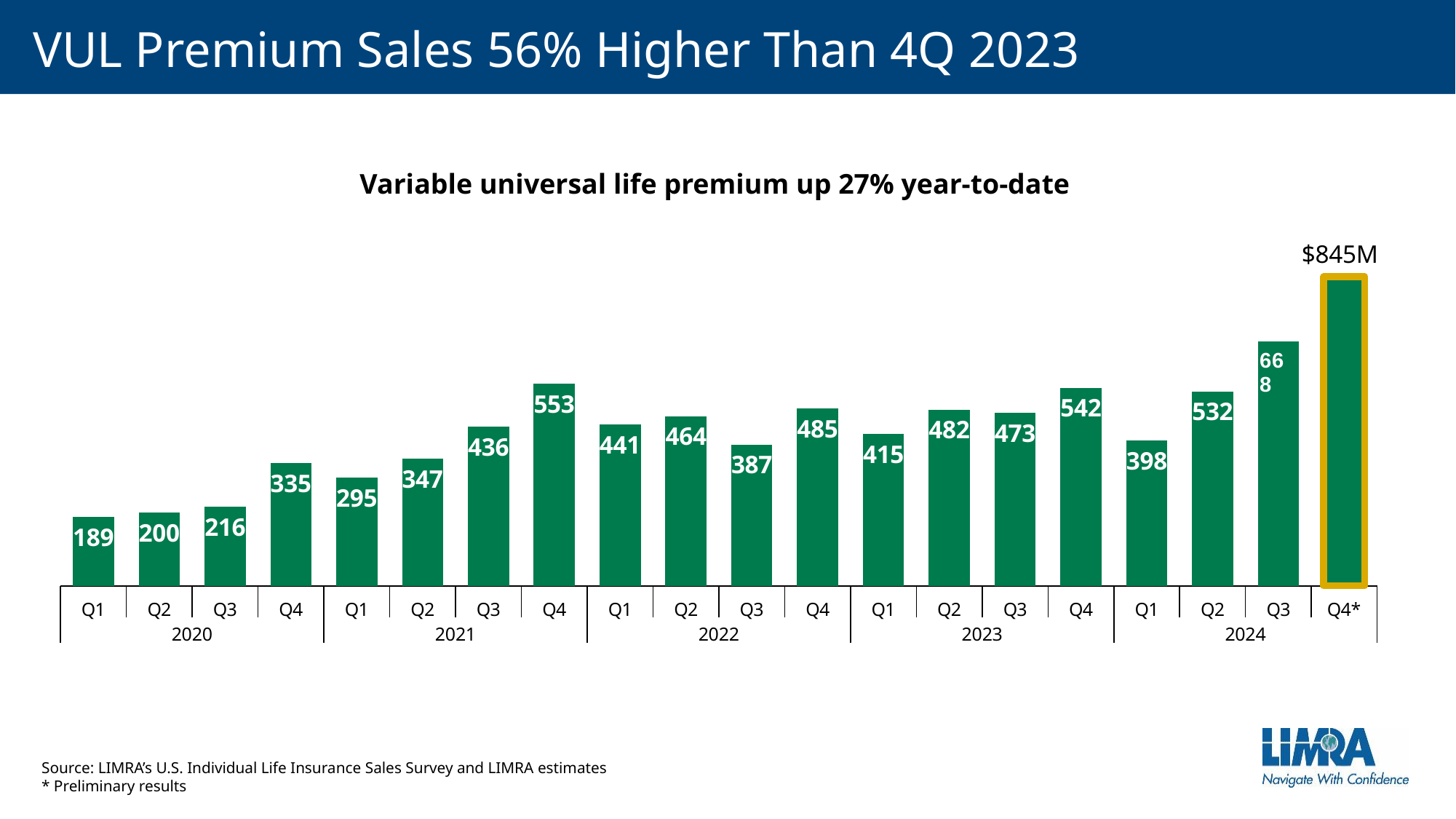
How many quarterly bars are plotted in the chart? 20 Which quarter has the highest value? Q4* 2024 What value is labelled above the Q4* 2024 bar? $845M What kind of chart is shown on the slide? Bar chart What is the difference between Q3 2024 and Q2 2024? 136 What is the value for Q4 2021? 553 What is the value for Q4 2023? 542 What is the value for Q1 2020? 189 What is the value for Q3 2022? 387 Which is larger, the value for Q2 2023 or the value for Q3 2023? Q2 2023 Which quarter has the lowest value? Q1 2020 What is the chart's subtitle? Variable universal life premium up 27% year-to-date